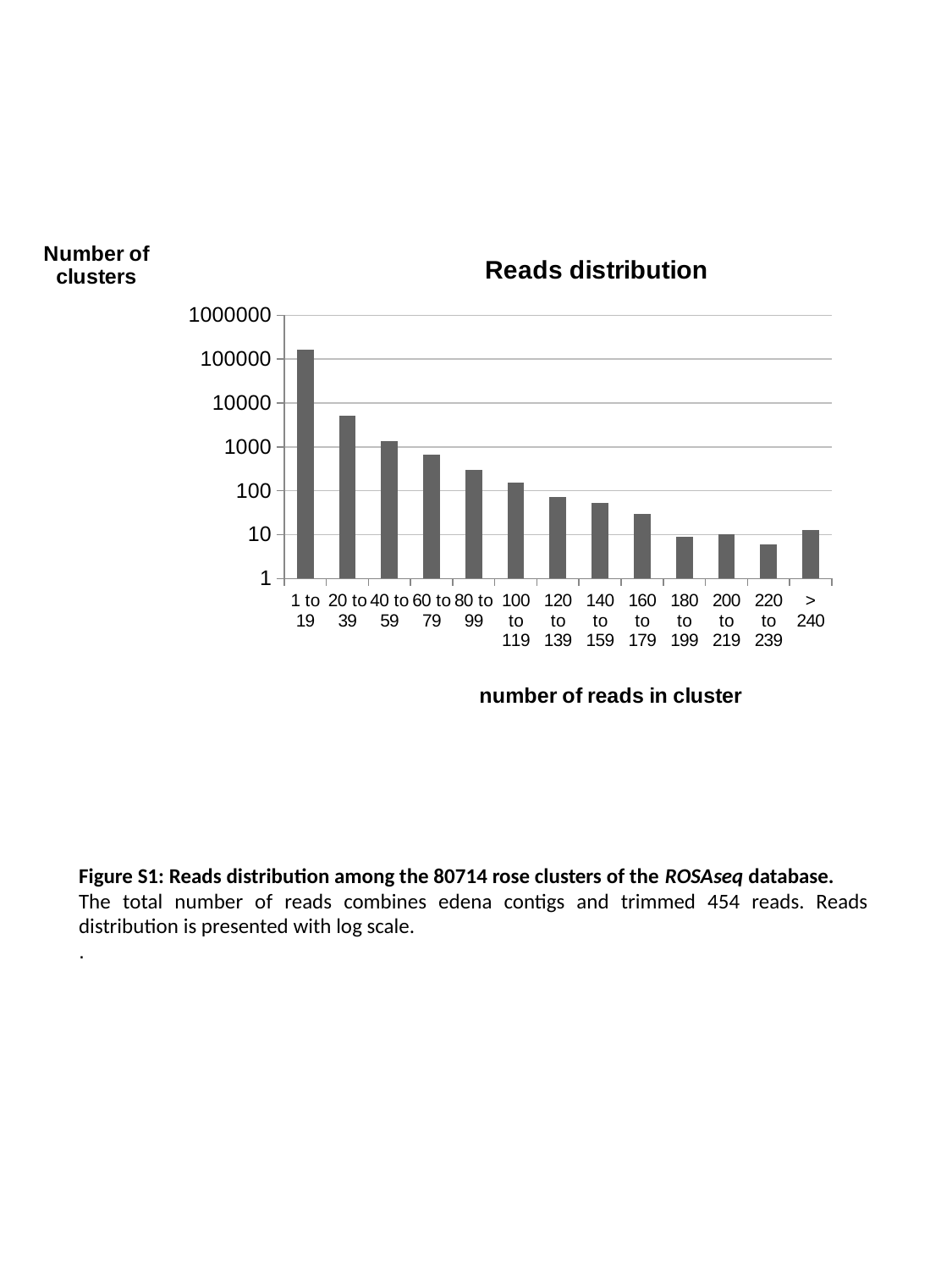
Is the value for 80 to 99 greater or less than 100? greater What is the title of the chart? Reads distribution Is the value for 1 to 19 greater or less than 100000? greater What kind of chart is shown on the slide? bar chart Which category has the highest number of clusters? 1 to 19 What is the label of the x axis of the chart? number of reads in cluster Is the value for 20 to 39 greater or less than 1000? greater How many categories are plotted along the x axis? 13 Which has more clusters, 1 to 19 or 20 to 39? 1 to 19 Do the values generally rise or fall as the number of reads in cluster increases along the x axis? fall